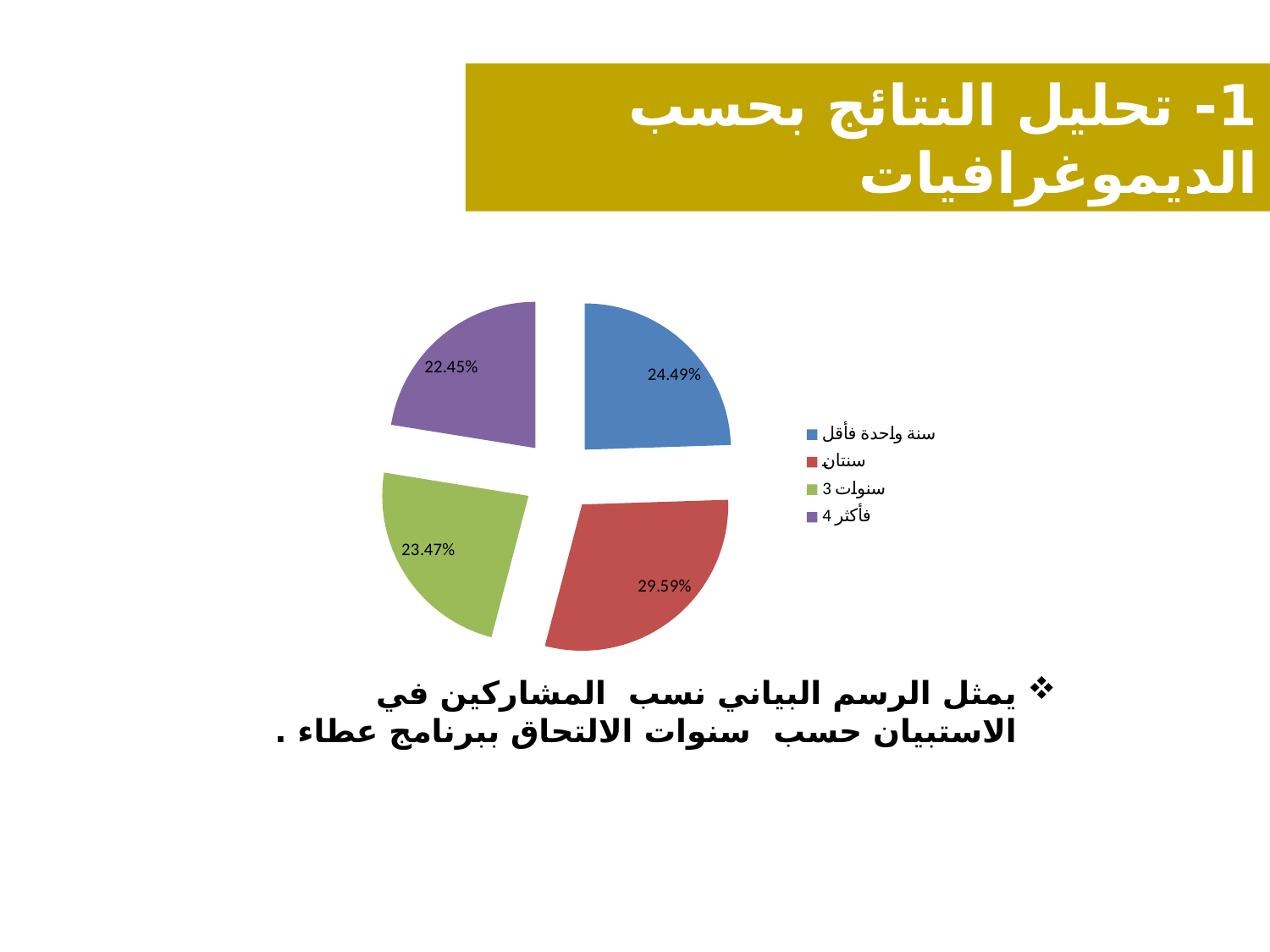
Which category has the largest slice of the pie? سنتان Which category has the smallest slice of the pie? 4 فأكثر What kind of chart is shown on the slide? pie chart What is the difference in percentage points between the slices for سنتان and 4 فأكثر? 7.14 What percentage of the pie is the slice for 4 فأكثر? 22.45% What colour is the slice for سنتان? red What percentage of the pie is the slice for سنتان? 29.59% What percentage of the pie is the slice for 3 سنوات? 23.47% How many slices does the pie chart have? 4 What percentage of the pie is the slice for سنة واحدة فأقل? 24.49% What colour is the slice for 4 فأكثر? purple Which slice is larger: سنة واحدة فأقل or 3 سنوات? سنة واحدة فأقل